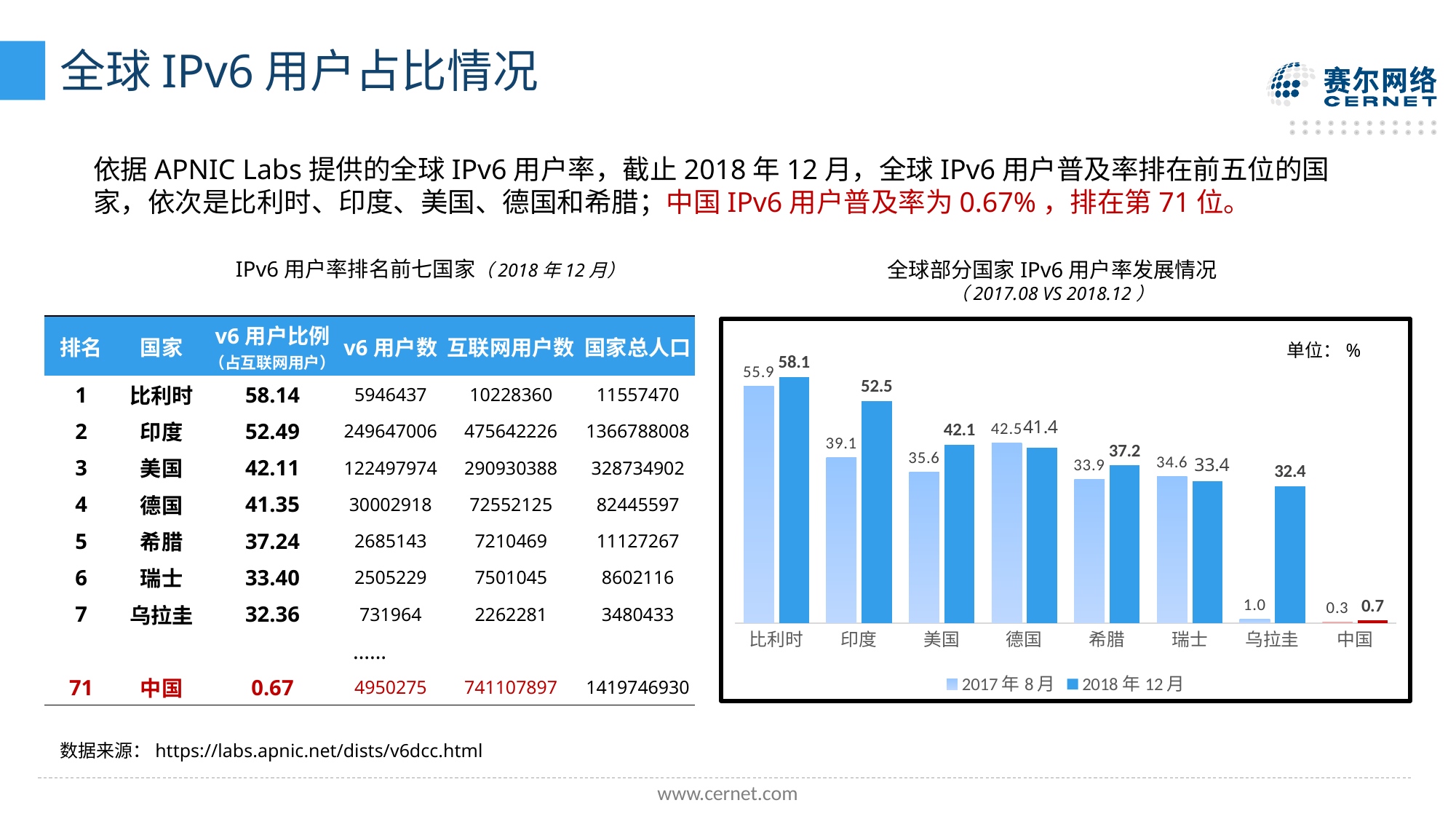
In the chart 全球部分国家 IPv6 用户率发展情况, what is the difference between the 2018 年 12 月 values of 比利时 and 印度? 5.6 In the chart 全球部分国家 IPv6 用户率发展情况, which is larger for 德国: the 2017 年 8 月 value or the 2018 年 12 月 value? 2017 年 8 月 How many countries are shown on the x axis of the chart 全球部分国家 IPv6 用户率发展情况? 8 In the chart 全球部分国家 IPv6 用户率发展情况, which country has the lowest value for 2017 年 8 月? 中国 In the chart 全球部分国家 IPv6 用户率发展情况, what is the value for 中国 in 2018 年 12 月? 0.7 In the chart 全球部分国家 IPv6 用户率发展情况, what is the value for 印度 in 2018 年 12 月? 52.5 In the chart 全球部分国家 IPv6 用户率发展情况, what is the value for 德国 in 2017 年 8 月? 42.5 In the chart 全球部分国家 IPv6 用户率发展情况, which country has the highest value for 2018 年 12 月? 比利时 How many series does the legend of the chart 全球部分国家 IPv6 用户率发展情况 list? 2 What unit is indicated in the top right corner of the chart 全球部分国家 IPv6 用户率发展情况? % What type of chart is shown on the right side of the slide? bar chart In the chart 全球部分国家 IPv6 用户率发展情况, by how much did the value for 乌拉圭 increase from 2017 年 8 月 to 2018 年 12 月? 31.4